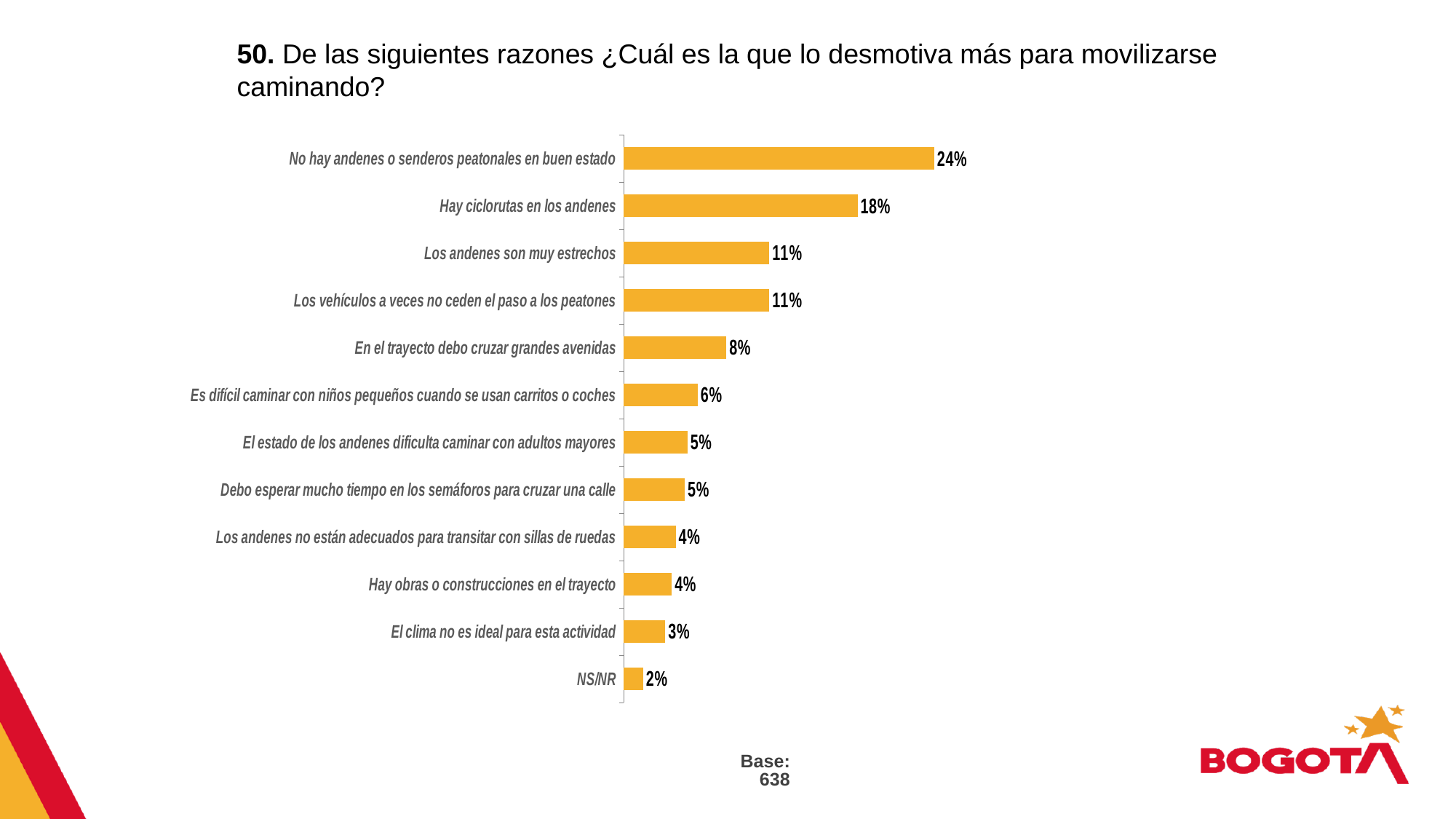
What is the base (number of respondents) shown below the chart? 638 Which is larger: "Es difícil caminar con niños pequeños cuando se usan carritos o coches" or "Hay obras o construcciones en el trayecto"? Es difícil caminar con niños pequeños cuando se usan carritos o coches Which reason has the highest percentage? No hay andenes o senderos peatonales en buen estado What is the difference between "No hay andenes o senderos peatonales en buen estado" and "Hay ciclorutas en los andenes"? 6 percentage points Which category has the lowest percentage? NS/NR What percentage of respondents chose "No hay andenes o senderos peatonales en buen estado"? 24% What is the value for "El clima no es ideal para esta actividad"? 3% What is the value for "En el trayecto debo cruzar grandes avenidas"? 8% What kind of chart is shown on the slide? Bar chart What colour are the bars in the chart? Orange/yellow How many categories are shown in the chart? 12 What is the value for "Hay ciclorutas en los andenes"? 18%